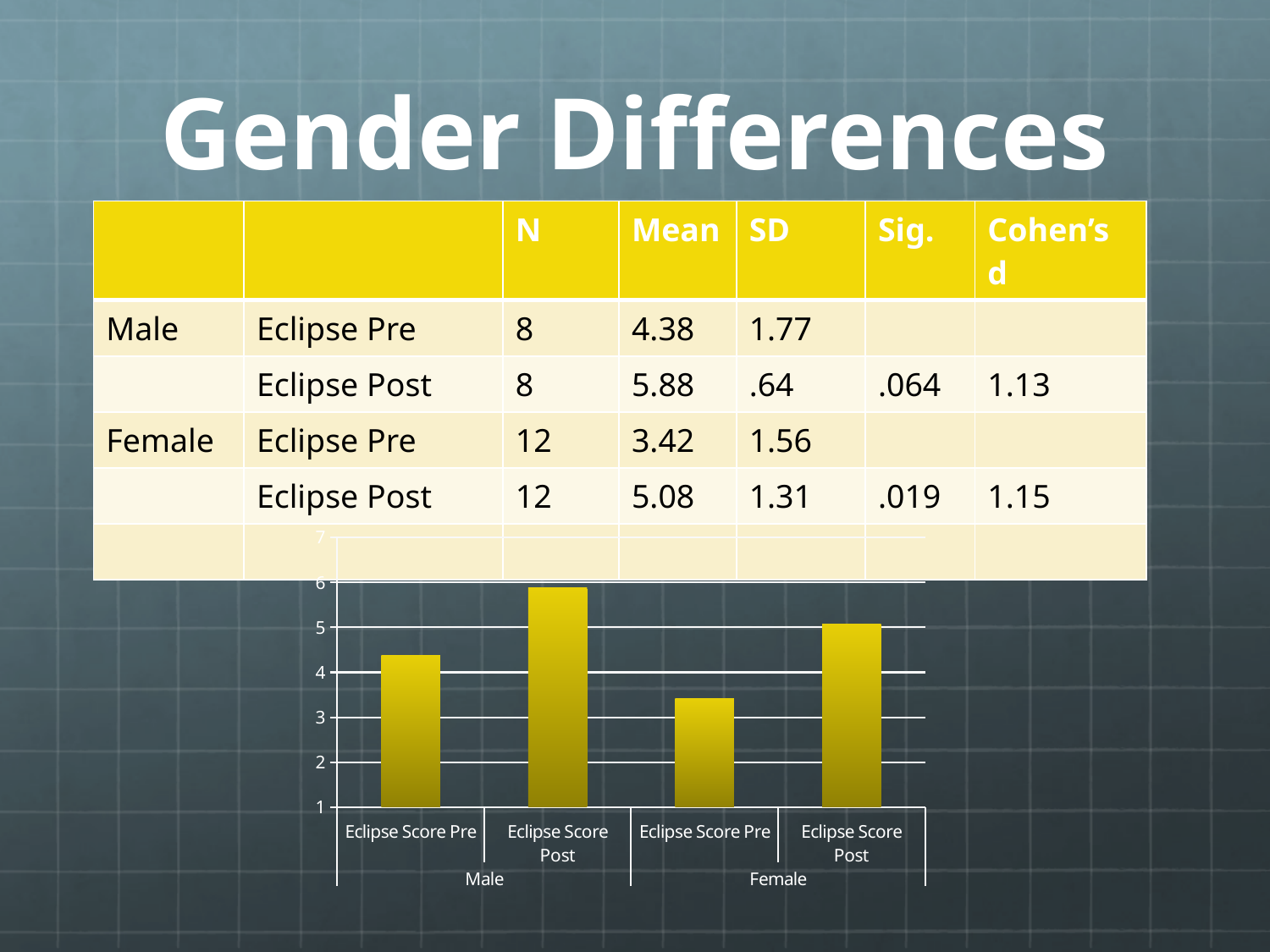
Is the value of the Female Eclipse Score Pre bar greater or less than 4? less What is the highest value shown on the chart's vertical axis? 7 Which is larger in the chart, the Male Eclipse Score Pre bar or the Female Eclipse Score Pre bar? Male Eclipse Score Pre Is the value of the Female Eclipse Score Post bar greater or less than 6? less How many gender groups are labelled along the chart's horizontal axis? 2 Is the value of the Male Eclipse Score Pre bar greater or less than 4? greater Which bar in the chart is the lowest? Female Eclipse Score Pre What kind of chart is shown at the bottom of the slide? bar chart Which is larger in the chart, the Male Eclipse Score Post bar or the Female Eclipse Score Post bar? Male Eclipse Score Post How many bars are plotted in the chart? 4 Which bar in the chart is the highest? Male Eclipse Score Post